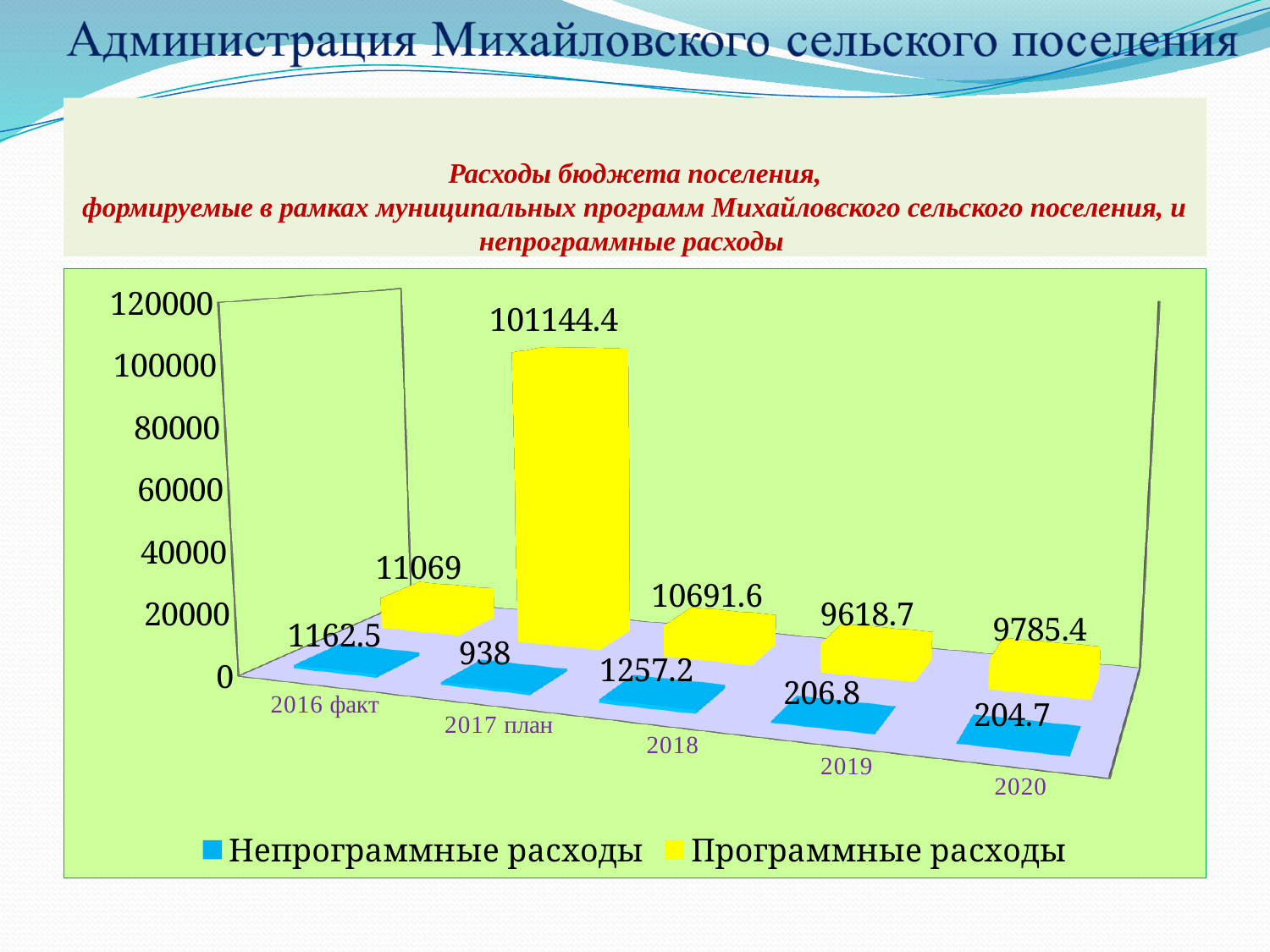
What is the value of Программные расходы for 2017 план? 101144.4 Is the value of Программные расходы for 2017 план greater or less than 100000? greater What is the difference between Программные расходы in 2020 and in 2019? 166.7 What is the value of Программные расходы for 2019? 9618.7 What kind of chart is shown on the slide? Bar chart How many categories (years) are shown on the x axis? 5 Which is larger: Непрограммные расходы in 2018 or in 2017 план? 2018 Which year has the lowest value of Непрограммные расходы? 2020 What is the value of Непрограммные расходы for 2020? 204.7 Which year has the highest value of Программные расходы? 2017 план How many series does the legend list? 2 What is the value of Непрограммные расходы for 2016 факт? 1162.5